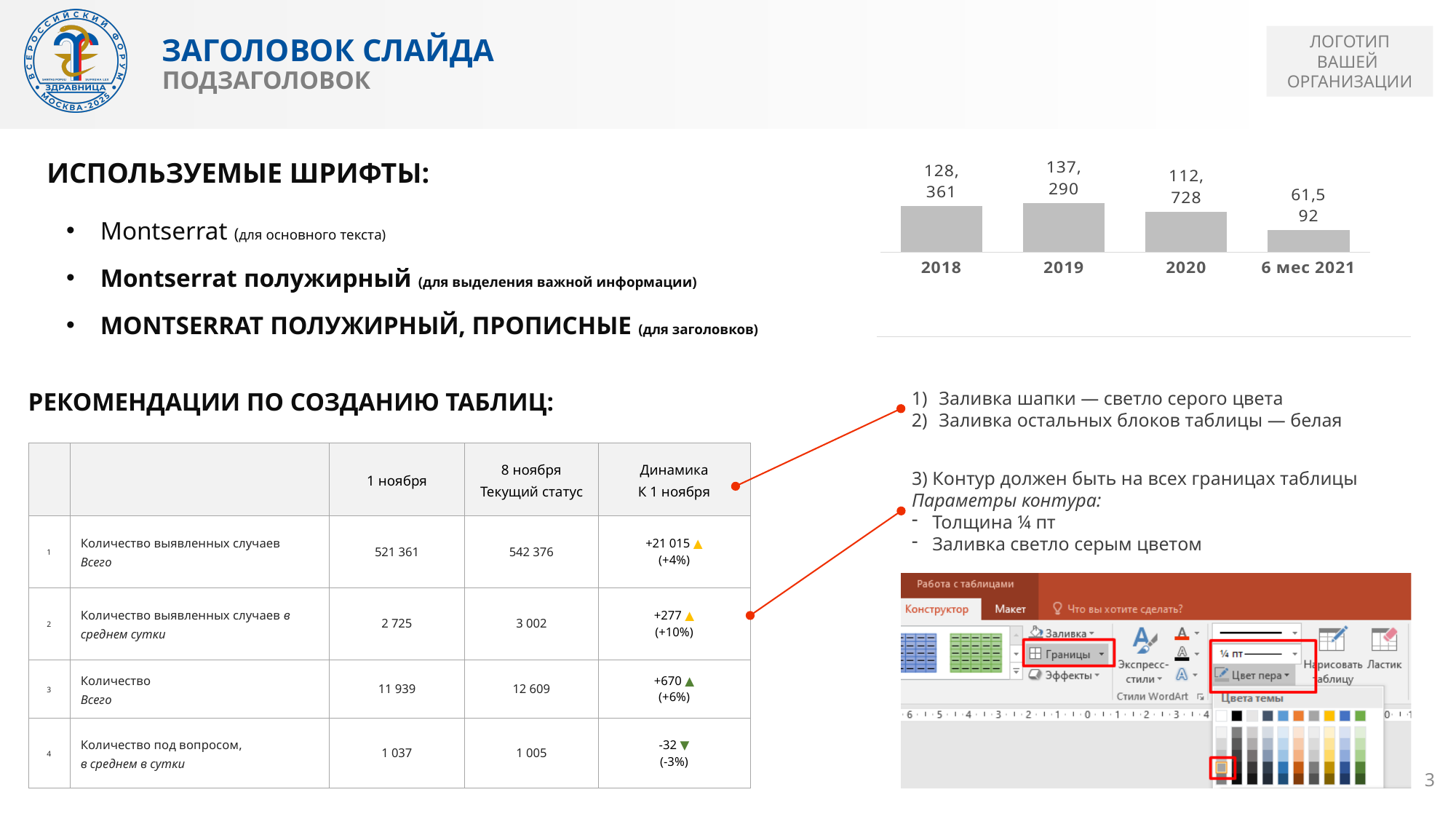
In the bar chart, what is the value shown for 2020? 112,728 In the bar chart, do the values rise or fall from 2019 to 6 мес 2021? fall In the bar chart, is the value for 2019 larger or smaller than the value for 2018? larger In the bar chart, which category has the highest value? 2019 In the bar chart, what is the value shown for 2018? 128,361 In the bar chart, what is the value shown for 6 мес 2021? 61,592 In the bar chart, which category has the lowest value? 6 мес 2021 What is the label of the last category on the x axis of the bar chart? 6 мес 2021 How many categories does the bar chart in the top right show? 4 In the bar chart, what is the value shown for 2019? 137,290 What kind of chart is shown in the top right of the slide? bar chart In the bar chart, is the value for 2020 larger or smaller than the value for 2018? smaller